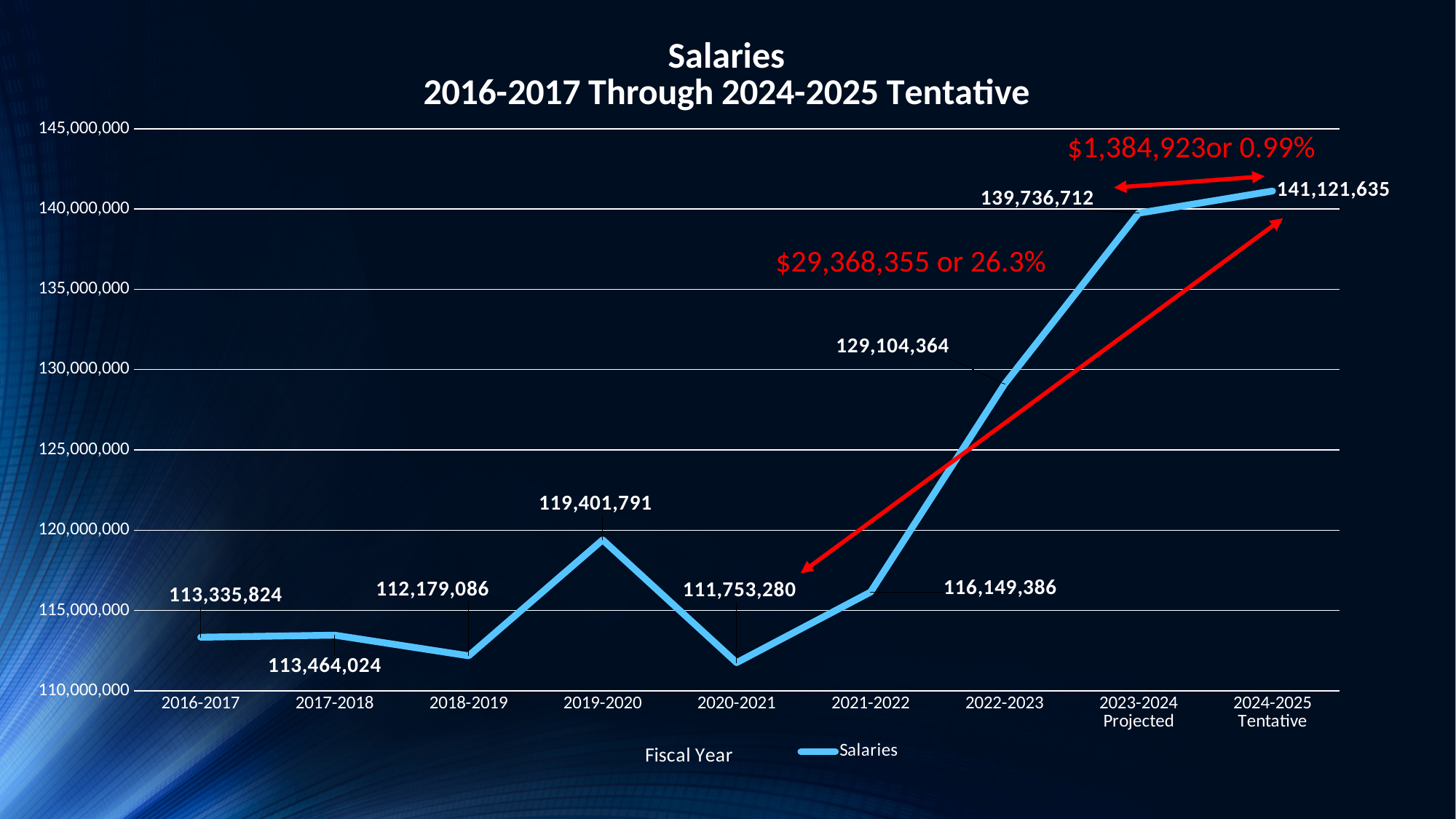
What is the salaries value for 2019-2020? 119,401,791 Is the salaries value for 2022-2023 greater or less than 125,000,000? greater How many fiscal years are plotted on the chart? 9 What is the salaries value for 2023-2024 Projected? 139,736,712 What is the difference between the salaries for 2022-2023 and 2021-2022? 12,954,978 Which fiscal year has the lowest salaries value? 2020-2021 Do the salaries rise or fall from 2021-2022 to 2024-2025 Tentative? rise Which is larger, the salaries value for 2017-2018 or for 2018-2019? 2017-2018 Which fiscal year has the highest salaries value? 2024-2025 Tentative What kind of chart is shown on the slide? line chart What is the difference between the salaries for 2024-2025 Tentative and 2023-2024 Projected? 1,384,923 What is the salaries value for 2022-2023? 129,104,364